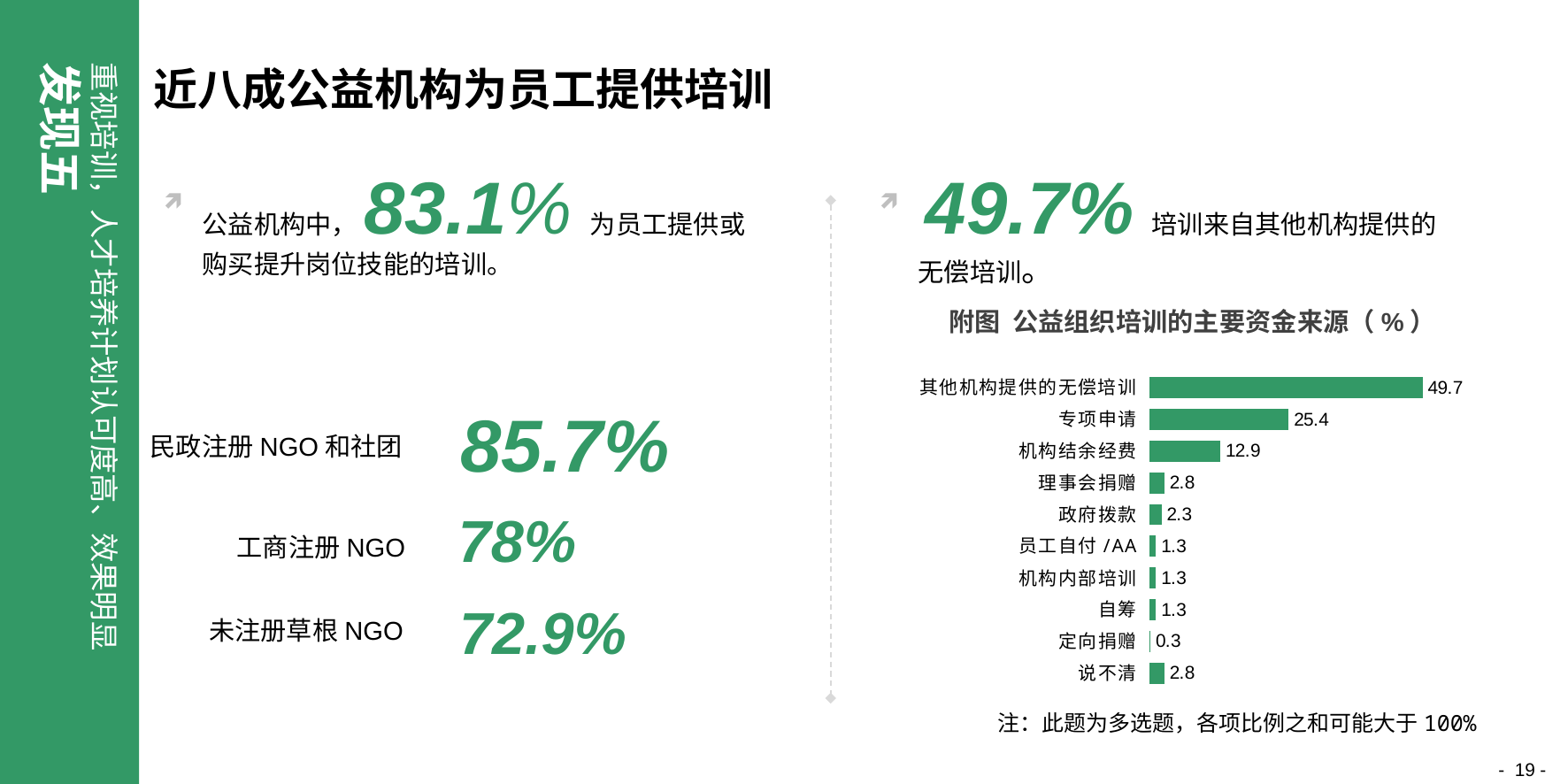
Which category has the highest value in the chart? 其他机构提供的无偿培训 What is the value for 机构结余经费 in the chart? 12.9 What is the value for 政府拨款 in the chart? 2.3 What is the value for 定向捐赠 in the chart? 0.3 What type of chart is shown on the slide? bar chart How many categories are shown in the chart? 10 What is the difference between the values for 机构结余经费 and 说不清? 10.1 Which category has the lowest value in the chart? 定向捐赠 Which is larger, the value for 理事会捐赠 or the value for 政府拨款? 理事会捐赠 What is the title of the chart? 附图 公益组织培训的主要资金来源（%） What is the value for 专项申请 in the chart? 25.4 What is the difference between the values for 其他机构提供的无偿培训 and 专项申请? 24.3